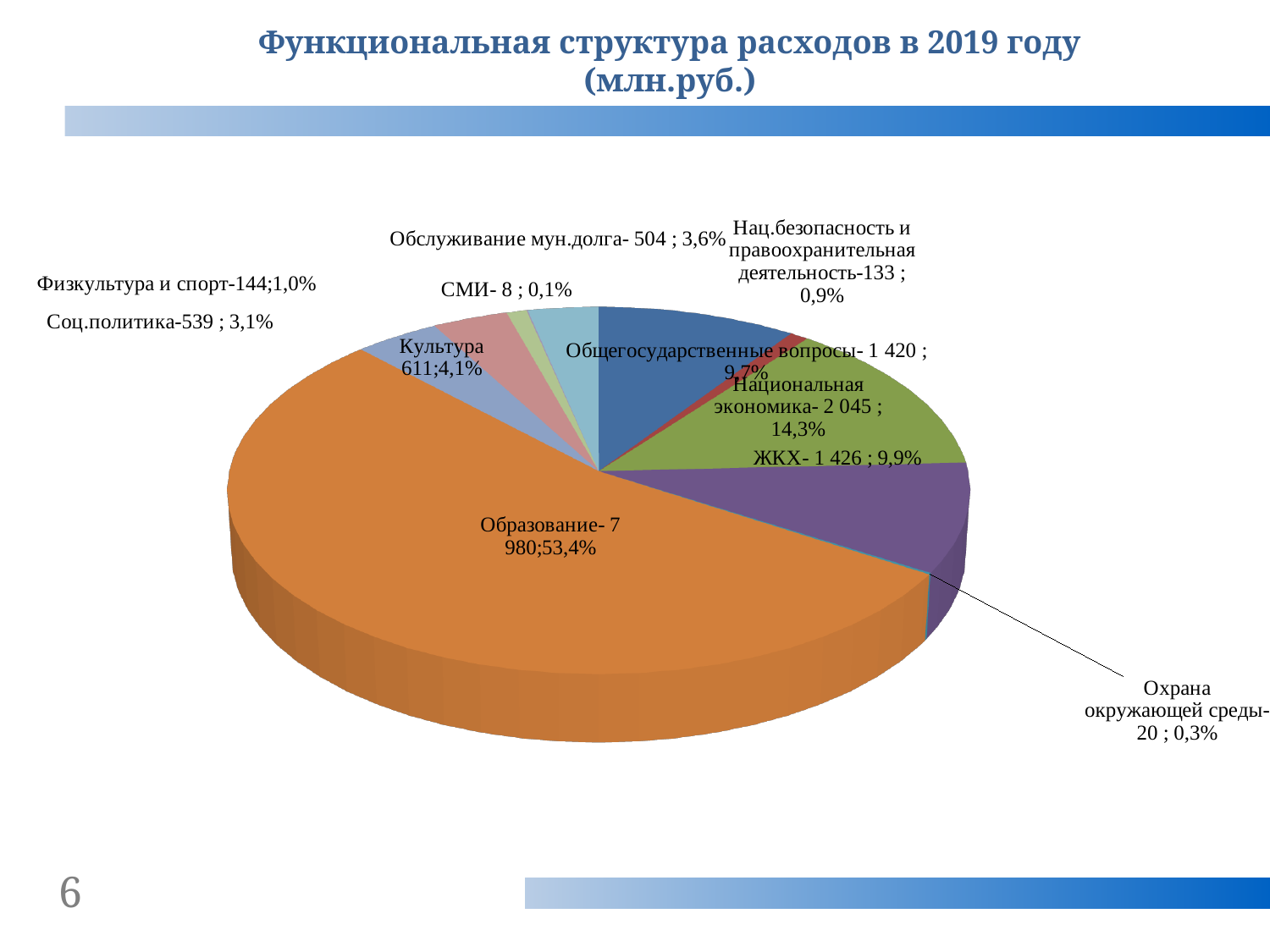
What is the title of the chart? Функциональная структура расходов в 2019 году (млн.руб.) What is the value for Национальная экономика? 2 045 Which is larger, Национальная экономика or Общегосударственные вопросы? Национальная экономика What kind of chart is shown on the slide? pie chart What share of the pie does ЖКХ account for? 9,9% Which category has the smallest slice of the pie? СМИ Which category has the largest slice of the pie? Образование What is the value for Образование? 7 980 What share of the pie does Образование account for? 53,4% How many categories are shown in the pie chart? 11 What is the difference between the values for Культура and Соц.политика? 72 What is the value for Обслуживание мун.долга? 504